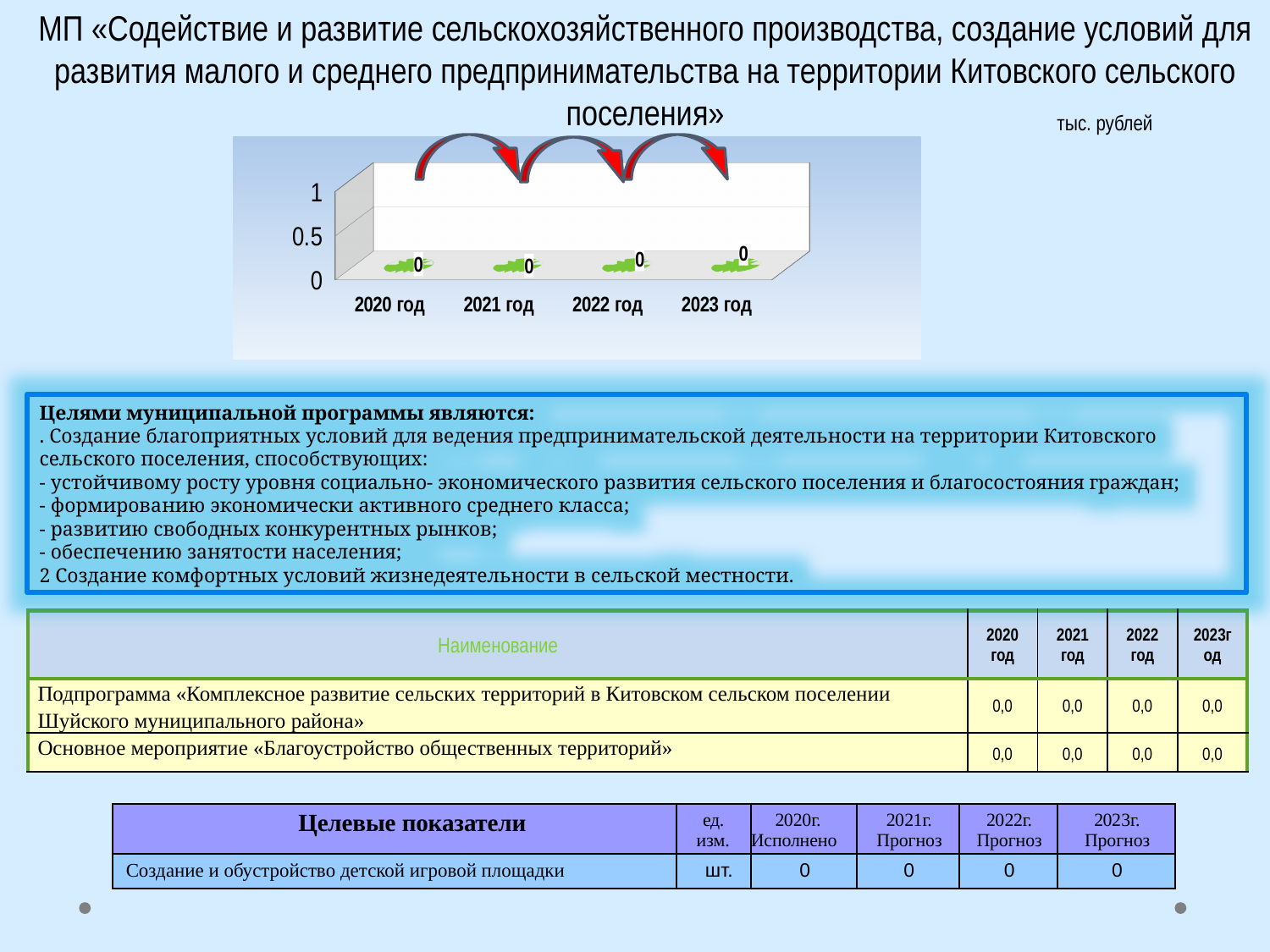
What is the highest tick value shown on the chart's vertical axis? 1 What is the value for 2020 год on the chart? 0 What is the value for 2022 год on the chart? 0 What is the difference between the values for 2023 год and 2020 год? 0 What is the value for 2023 год on the chart? 0 What kind of chart is shown on the slide? bar chart Is the value for 2022 год greater or less than 0.5? less Is the value for 2021 год greater or less than 1? less What is the value for 2021 год on the chart? 0 What unit is indicated for the chart values on the slide? тыс. рублей Do the values rise, fall, or stay the same from 2020 год to 2023 год? stay the same How many categories (years) are shown on the chart's x axis? 4